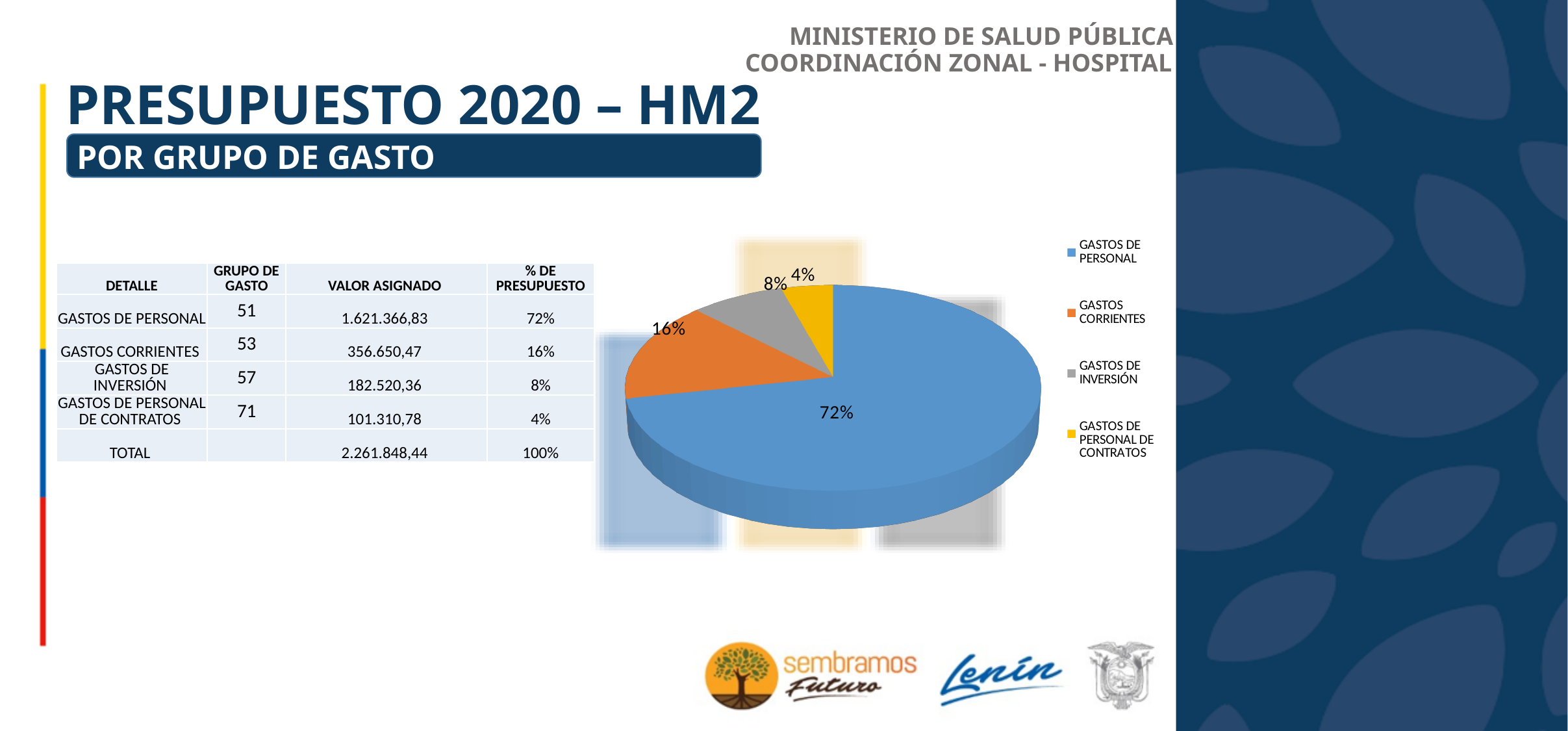
What share of the pie does GASTOS DE INVERSIÓN represent? 8% Which category has the largest slice of the pie? GASTOS DE PERSONAL What share of the pie does GASTOS DE PERSONAL represent? 72% What share of the pie does GASTOS DE PERSONAL DE CONTRATOS represent? 4% Which category has the smallest slice of the pie? GASTOS DE PERSONAL DE CONTRATOS How many slices does the pie chart have? 4 How many entries does the legend list? 4 What kind of chart is shown on the slide? Pie chart What is the difference in percentage points between the GASTOS DE PERSONAL slice and the GASTOS CORRIENTES slice? 56 What colour is the GASTOS DE INVERSIÓN slice? Grey Which slice is larger, GASTOS CORRIENTES or GASTOS DE INVERSIÓN? GASTOS CORRIENTES